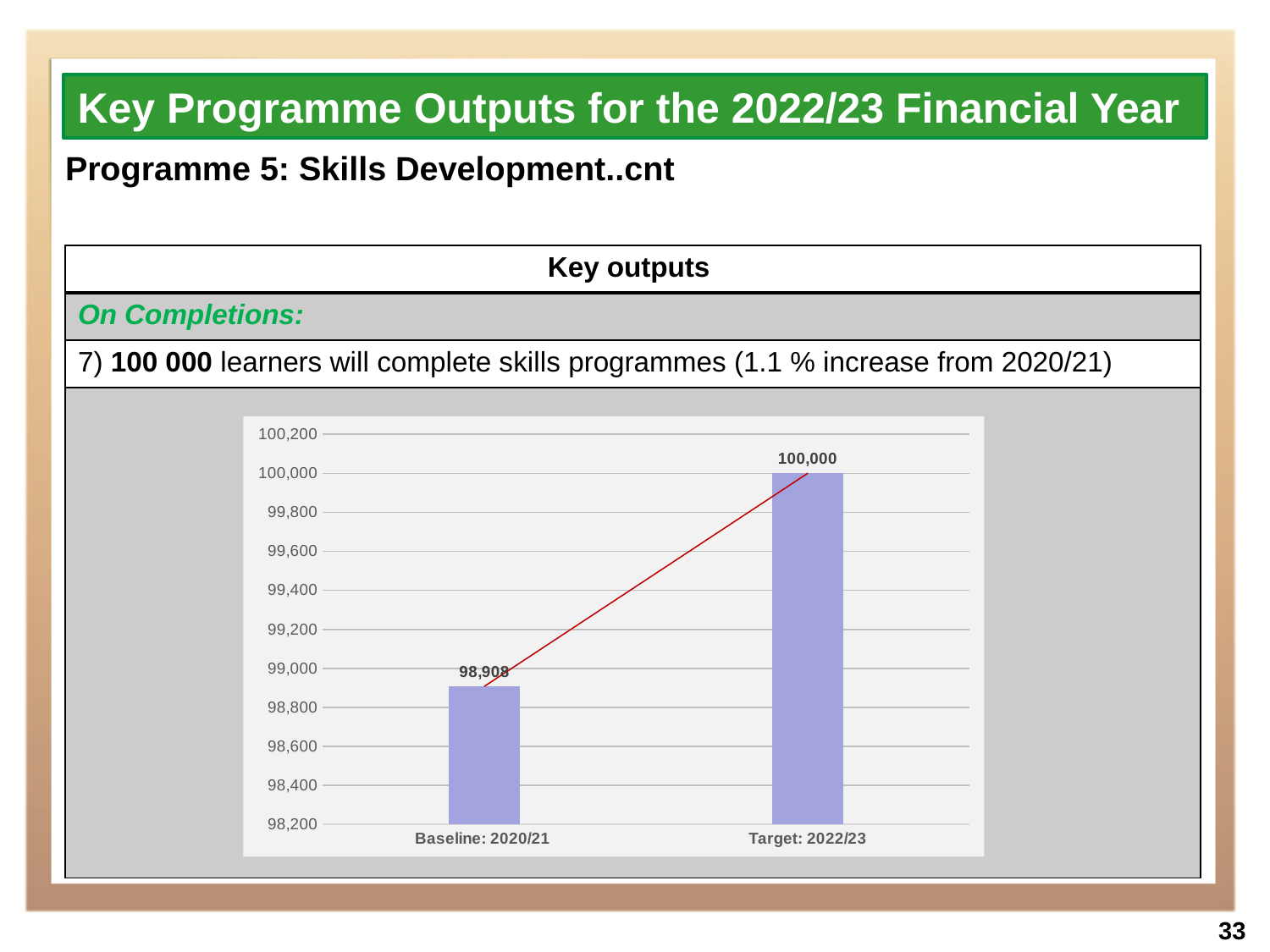
Which category has the lowest value? Baseline: 2020/21 What is the value for Target: 2022/23? 100,000 Is the value for Baseline: 2020/21 greater or less than 99,000? less Which category has the highest value? Target: 2022/23 Which is larger, the value for Baseline: 2020/21 or the value for Target: 2022/23? Target: 2022/23 Do the values rise or fall from Baseline: 2020/21 to Target: 2022/23? rise What kind of chart is shown on the slide? bar chart What is the lowest value shown on the y axis? 98,200 What is the value for Baseline: 2020/21? 98,908 What colour are the bars in the chart? purple Is the value for Target: 2022/23 greater or less than 99,800? greater How many categories are shown on the x axis? 2